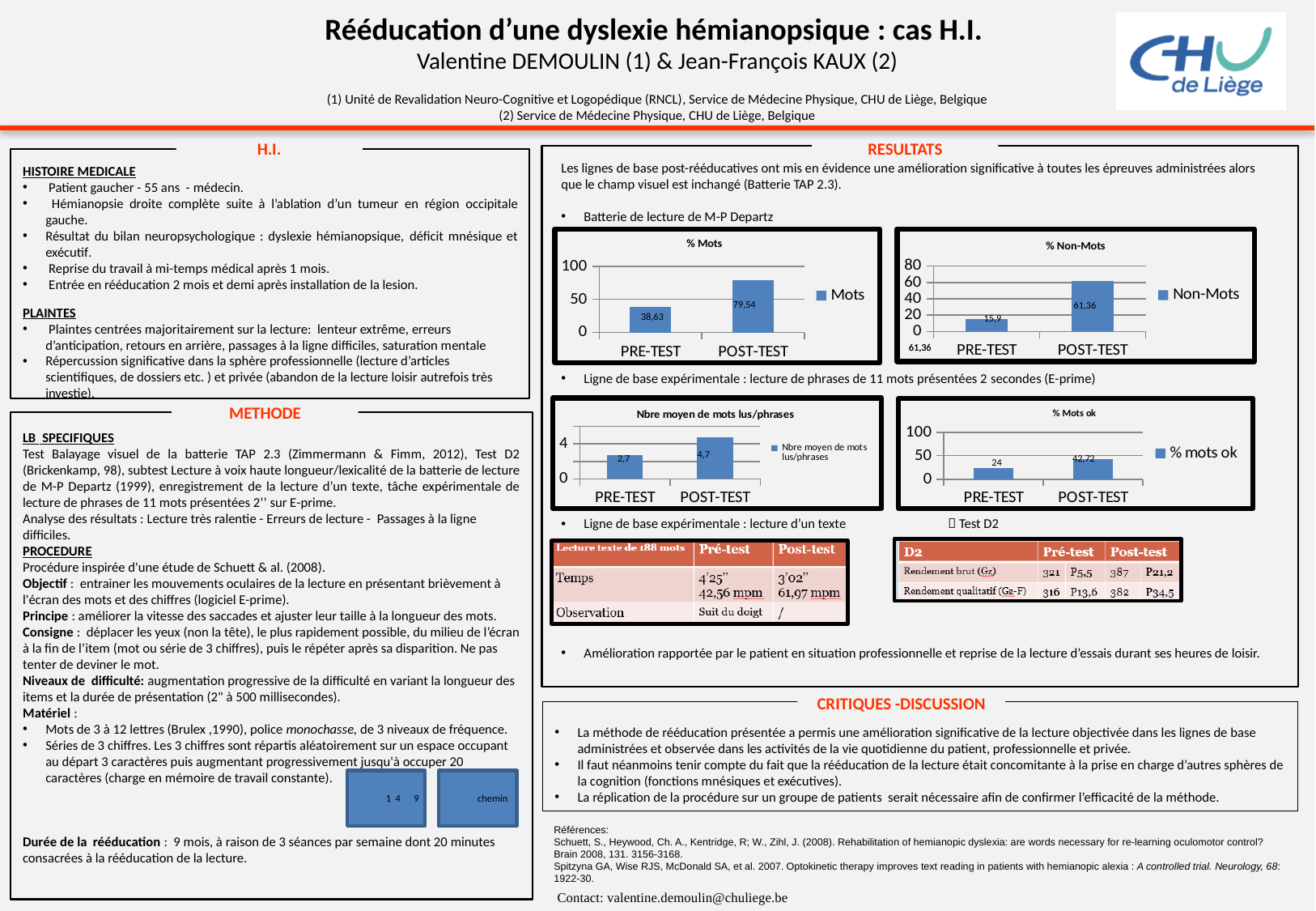
In the "% Non-Mots" chart, is the value for POST-TEST greater or less than 40? greater In the "% Non-Mots" chart, what is the value for PRE-TEST? 15,9 In the "Nbre moyen de mots lus/phrases" chart, what is the value for POST-TEST? 4,7 What legend entry is shown in the "% Non-Mots" chart? Non-Mots In the "% Mots" chart, what is the value for PRE-TEST? 38,63 What kind of chart is the "% Mots" chart? bar chart In the "% Non-Mots" chart, what is the value for POST-TEST? 61,36 In the "Nbre moyen de mots lus/phrases" chart, what is the difference between POST-TEST and PRE-TEST? 2 How many categories are shown on the x axis of the "% Mots ok" chart? 2 In the "% Mots ok" chart, which category has the higher value, PRE-TEST or POST-TEST? POST-TEST In the "% Mots ok" chart, what is the value for PRE-TEST? 24 In the "% Mots" chart, what is the value for POST-TEST? 79,54